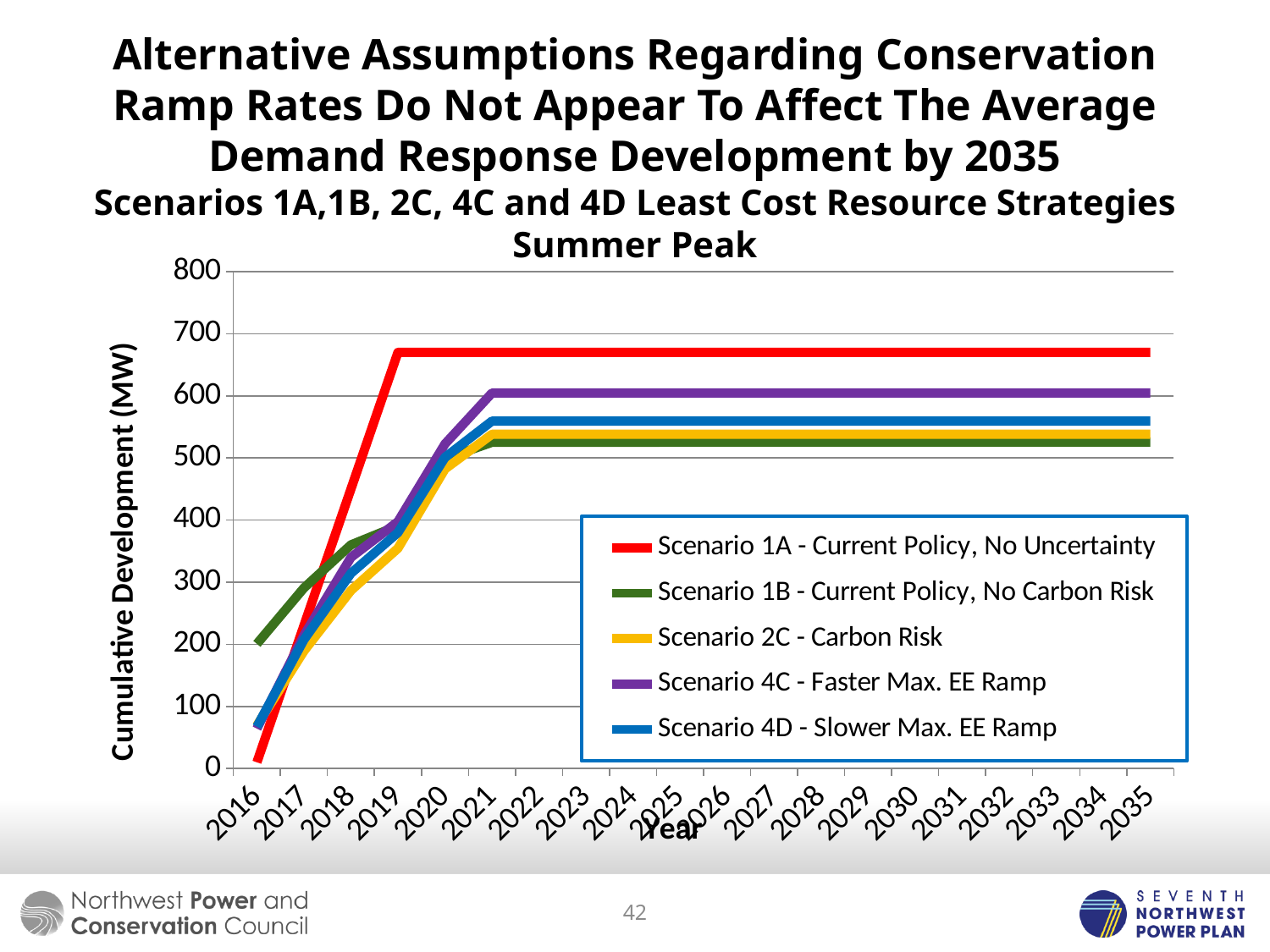
How many years are shown along the x axis? 20 Do the values for Scenario 1A rise or fall from 2016 to 2019? rise Is the value for Scenario 4D in 2035 greater or less than 600? less Which scenario has the lowest cumulative development in 2016? Scenario 1A - Current Policy, No Uncertainty Is the value for Scenario 1B in 2016 greater or less than 100? greater Is the value for Scenario 1A in 2035 greater or less than 600? greater What is the label on the y axis of the chart? Cumulative Development (MW) What kind of chart is shown on the slide? line chart How many series does the legend list? 5 In 2035, which is larger: Scenario 1A or Scenario 4D? Scenario 1A Which scenario has the highest cumulative development in 2035? Scenario 1A - Current Policy, No Uncertainty In 2016, which is larger: Scenario 1B or Scenario 1A? Scenario 1B